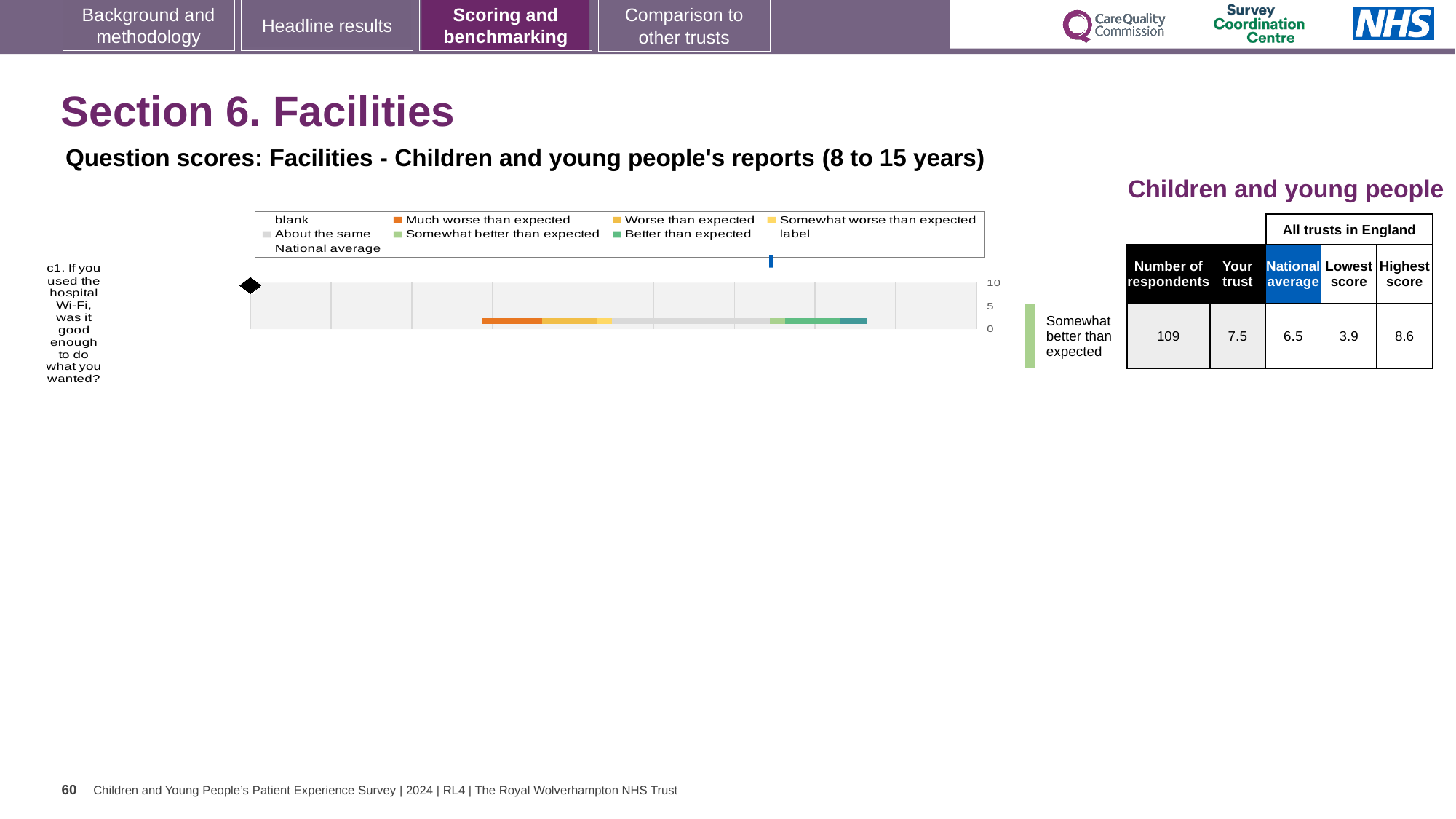
What is the highest score among all trusts in England for question c1? 8.6 What is the 'Your trust' score for question c1? 7.5 How many survey questions are plotted in the chart? 1 What is the text of the question plotted in the chart? c1. If you used the hospital Wi-Fi, was it good enough to do what you wanted? How many respondents answered question c1? 109 What is the lowest score among all trusts in England for question c1? 3.9 What type of chart is used to show the question score for c1? bar chart Which benchmark category is the trust's result for question c1 placed in? Somewhat better than expected What is the national average score for question c1? 6.5 Which is larger for question c1, the 'Your trust' score or the national average? Your trust What is the difference between the highest score and the lowest score for question c1? 4.7 What is the difference between the 'Your trust' score and the national average for question c1? 1.0